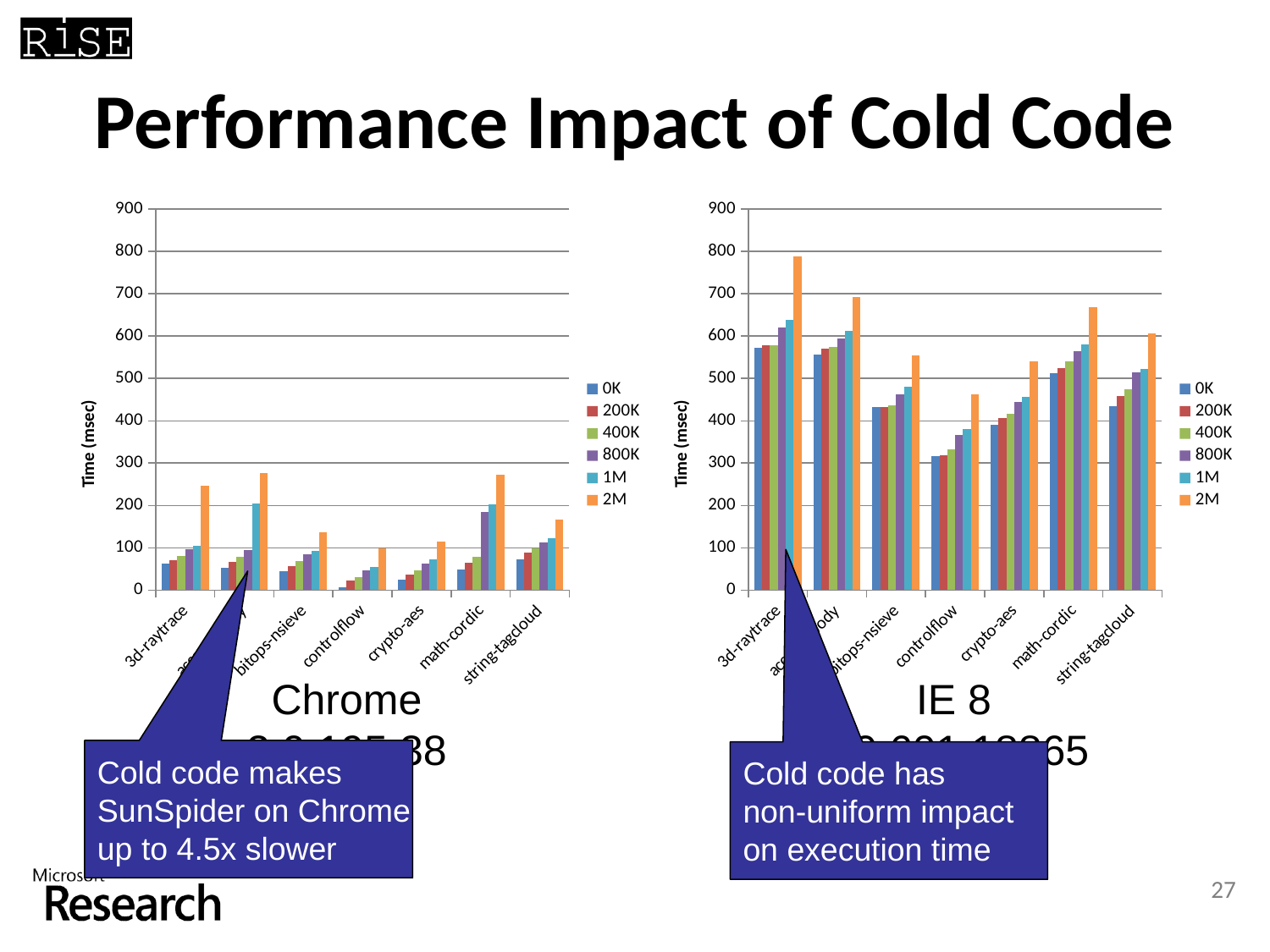
What is the y-axis label of the left chart (Chrome)? Time (msec) In the right chart (IE 8), is the 0K value for controlflow greater or less than 400? less How many benchmark categories are shown on the x axis of the right chart (IE 8)? 7 What kind of chart is the left chart (Chrome)? bar chart In the right chart (IE 8), which benchmark has the lowest 0K value? controlflow In the left chart (Chrome), is the 2M value for 3d-raytrace greater or less than 200? greater In the left chart (Chrome), is the 0K value for 3d-raytrace greater or less than 100? less In the right chart (IE 8), do the values for 3d-raytrace rise or fall from the 0K series to the 2M series? rise In the right chart (IE 8), which benchmark has the highest 2M value? 3d-raytrace In the left chart (Chrome), which is larger for math-cordic: the 0K value or the 2M value? 2M How many series does the legend of the right chart (IE 8) list? 6